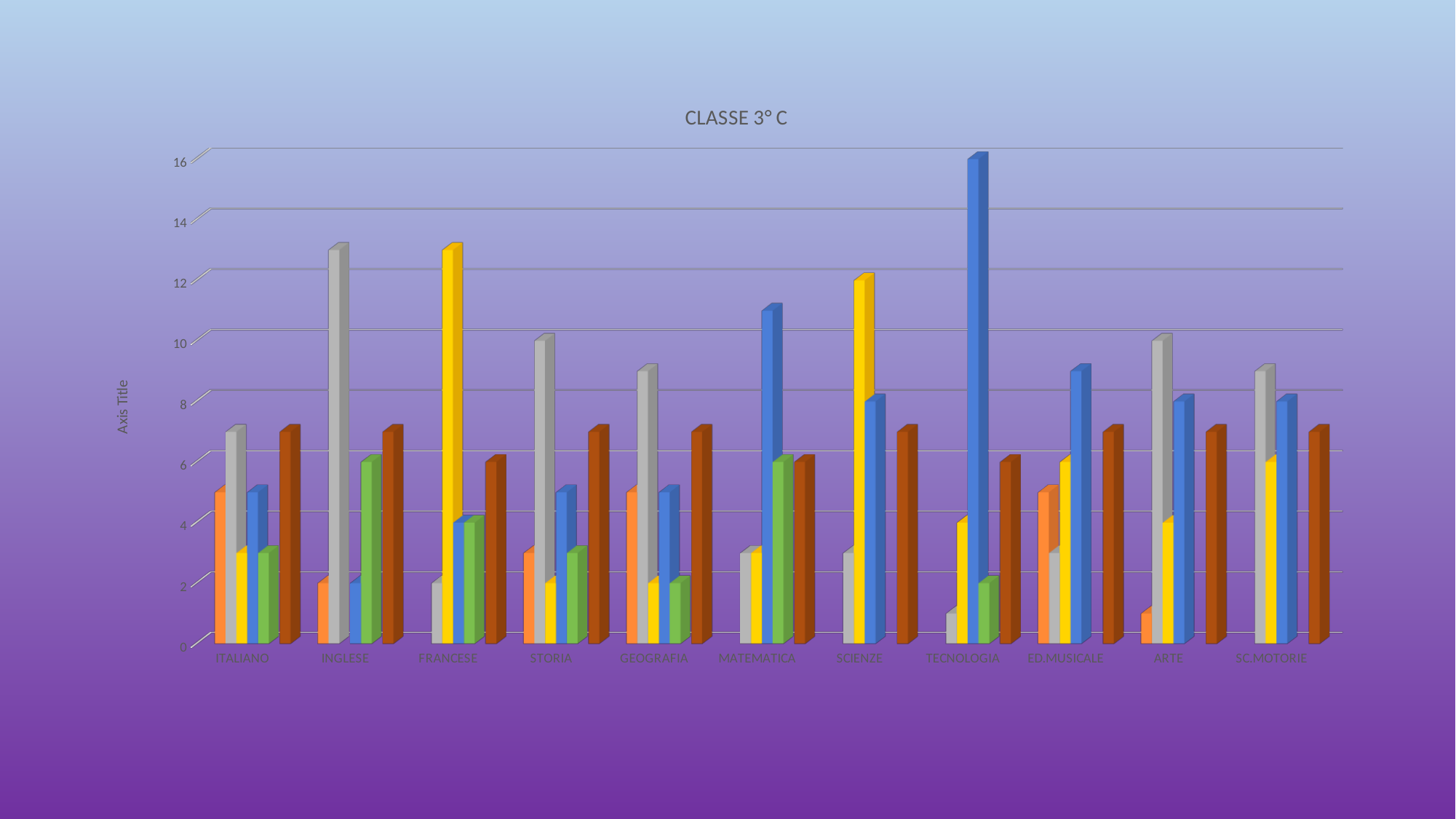
Which category contains the tallest bar in the chart? TECNOLOGIA Is the tallest bar for STORIA greater or less than 12? less What kind of chart is shown on the slide? bar chart Is the tallest bar for TECNOLOGIA greater or less than 14? greater Is the tallest bar for INGLESE greater or less than 12? greater How many categories are shown along the x axis of the chart? 11 Which category has the taller maximum bar, TECNOLOGIA or SCIENZE? TECNOLOGIA What is the title of the chart? CLASSE 3° C What is the highest value shown on the vertical axis of the chart? 16